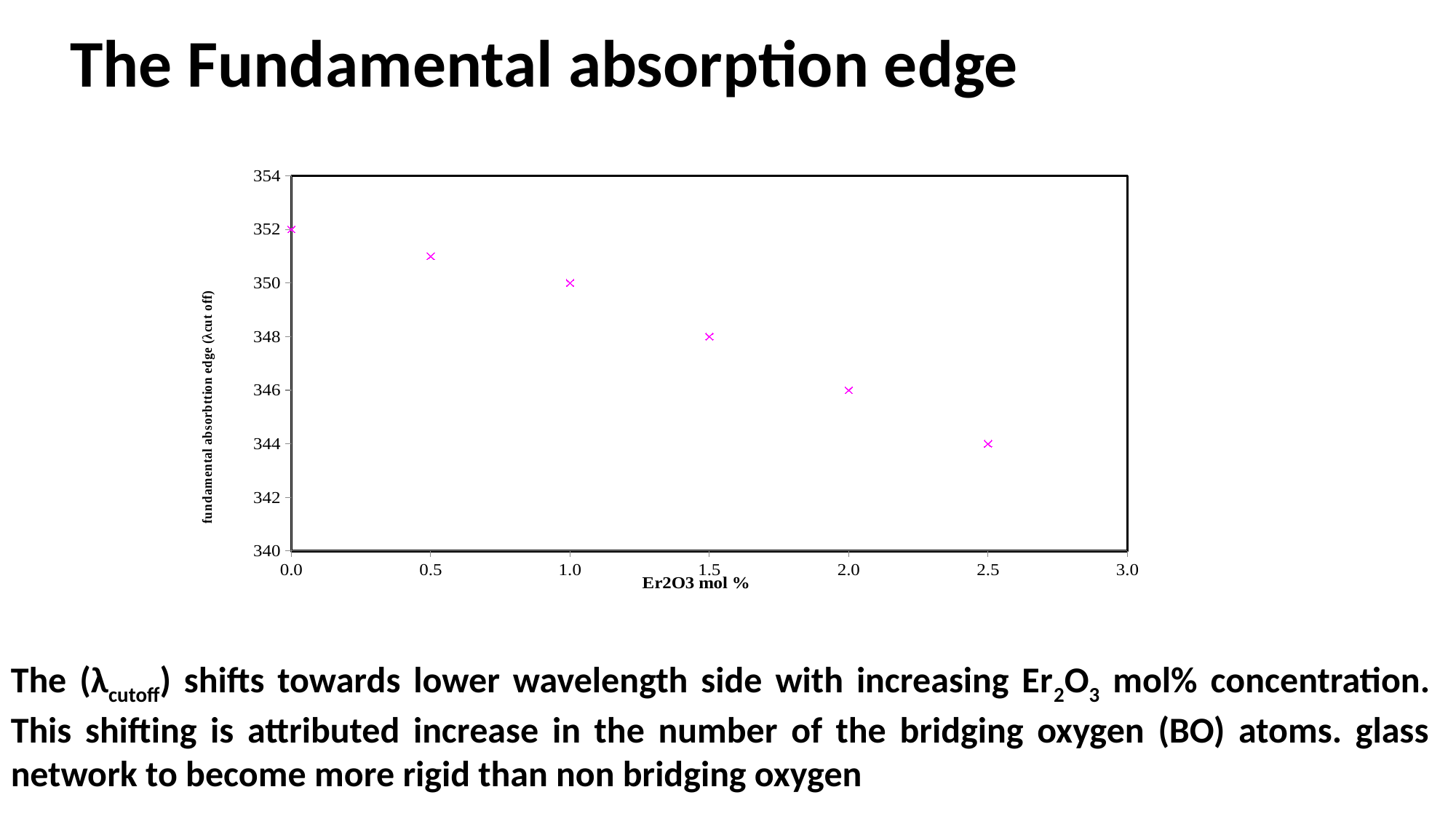
What is the fundamental absorption edge value at 2.5 Er2O3 mol %? 344 What is the fundamental absorption edge value at 1.0 Er2O3 mol %? 350 What is the difference between the fundamental absorption edge at 0.0 and at 2.5 Er2O3 mol %? 8 Is the value at 0.5 Er2O3 mol % greater or less than 350? greater What is the fundamental absorption edge value at 2.0 Er2O3 mol %? 346 At which Er2O3 mol % is the fundamental absorption edge highest? 0.0 What is the fundamental absorption edge value at 0.0 Er2O3 mol %? 352 Do the plotted values rise or fall as Er2O3 mol % increases? fall How many data points are plotted on the chart? 6 What kind of chart is shown on the slide? scatter plot At which Er2O3 mol % is the fundamental absorption edge lowest? 2.5 What is the fundamental absorption edge value at 1.5 Er2O3 mol %? 348